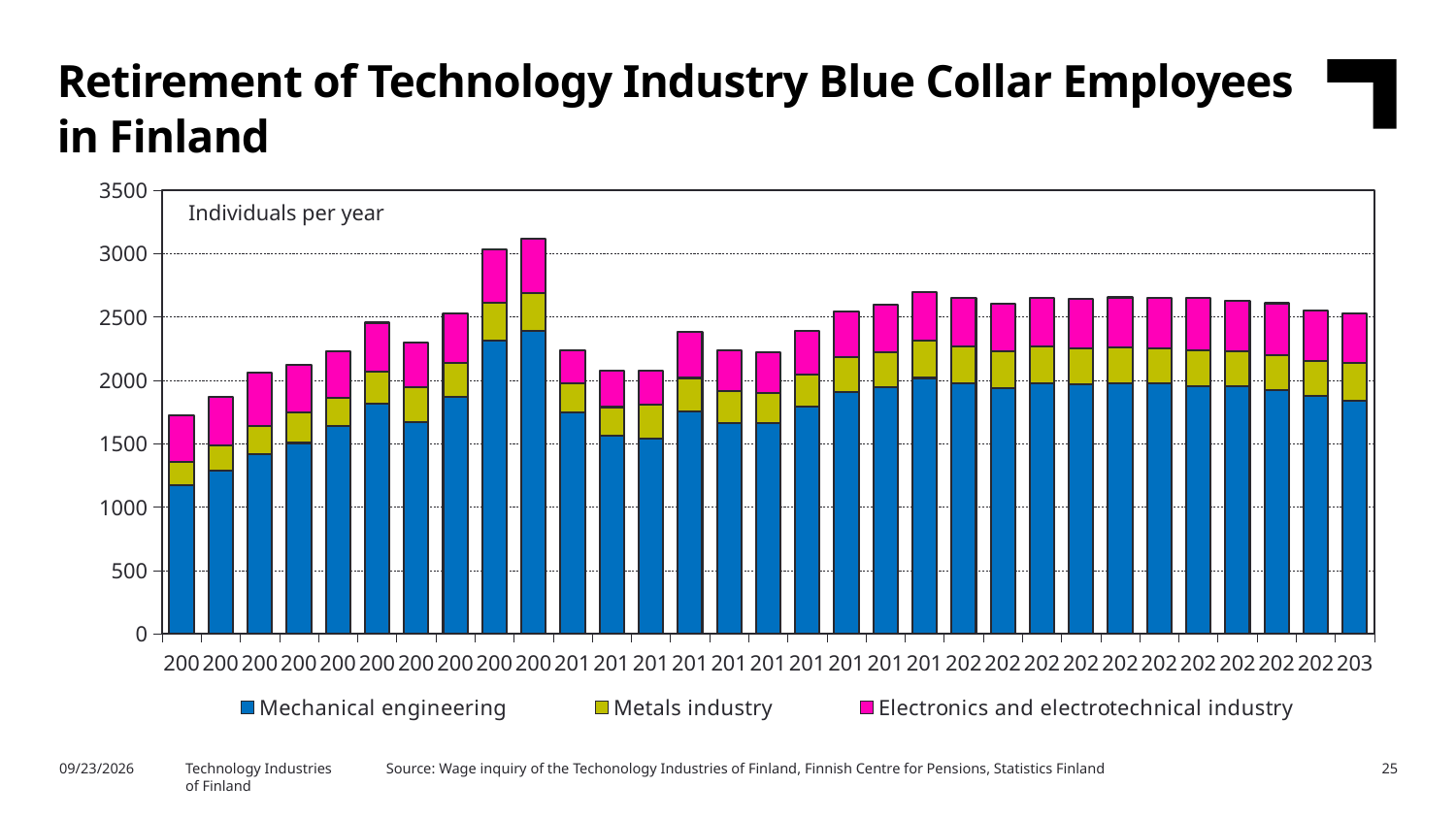
Is the total of the tallest bar greater or less than 3000? greater How many series does the legend list? 3 Is the Mechanical engineering segment of the tallest bar greater or less than 2000? greater What kind of chart is shown on the slide? Stacked bar chart What unit label is shown inside the plot area? Individuals per year Do the bar totals generally rise or fall across the first ten bars from left to right? rise Is the total of the first (leftmost) bar greater or less than 2000? less Which series forms the smallest segment in the first (leftmost) bar? Metals industry Which series forms the largest segment in every bar? Mechanical engineering What are the three series named in the legend? Mechanical engineering, Metals industry, Electronics and electrotechnical industry How many bars are plotted in the chart? 31